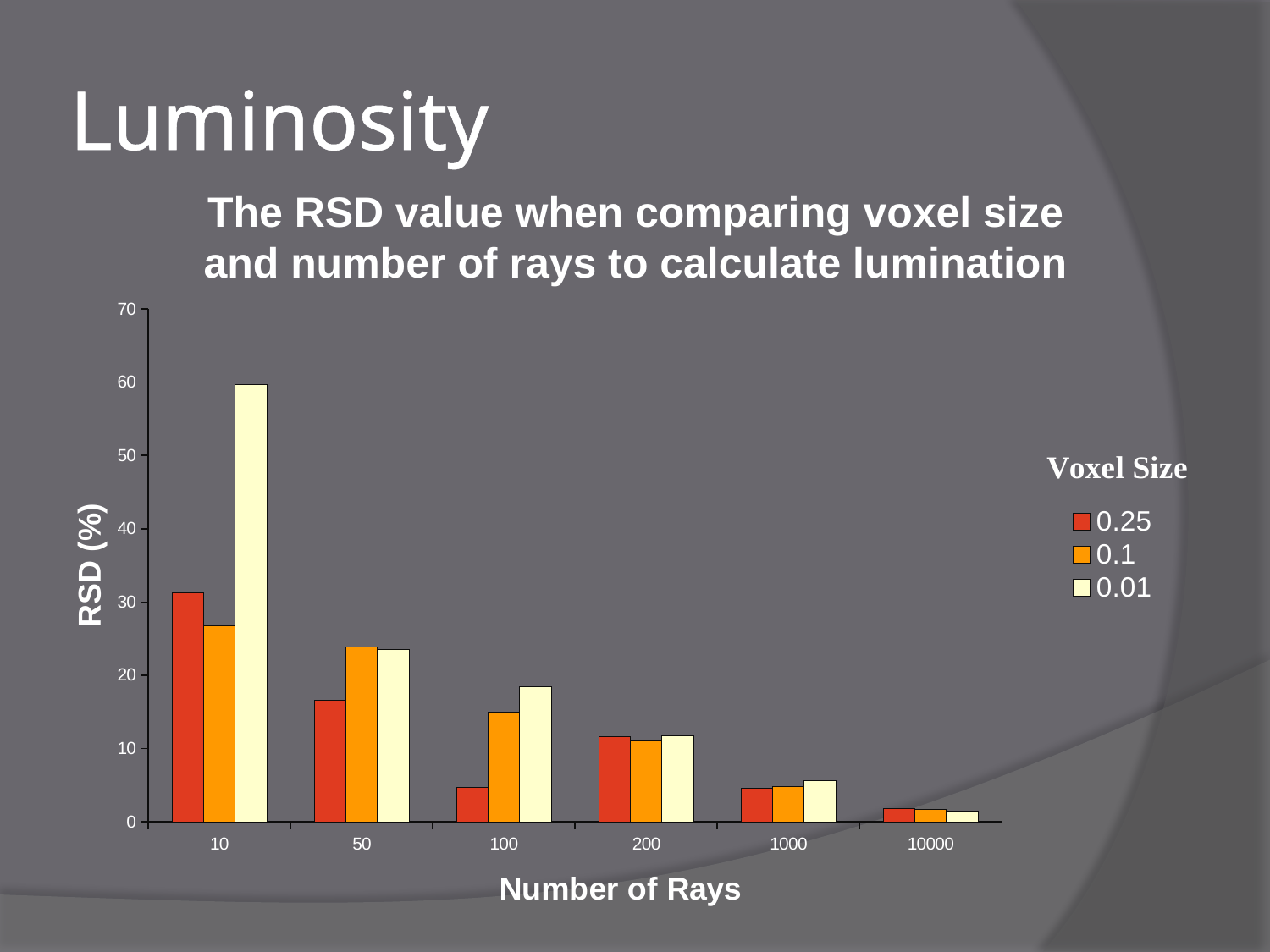
What is the title of the legend? Voxel Size What kind of chart is shown on the slide? bar chart At 10 rays, which voxel size has the larger RSD value, 0.01 or 0.25? 0.01 Is the RSD value for voxel size 0.01 at 10 rays greater or less than 50? greater For voxel size 0.25, at which number of rays is the RSD lowest? 10000 For voxel size 0.01, at which number of rays is the RSD highest? 10 How many Number of Rays categories are shown on the x axis? 6 Is the RSD value for voxel size 0.25 at 10 rays greater or less than 20? greater How many series does the legend list? 3 For voxel size 0.01, do the RSD values generally rise or fall as the number of rays increases? fall At 100 rays, which voxel size has the larger RSD value, 0.25 or 0.1? 0.1 Is the RSD value for voxel size 0.25 at 100 rays greater or less than 10? less